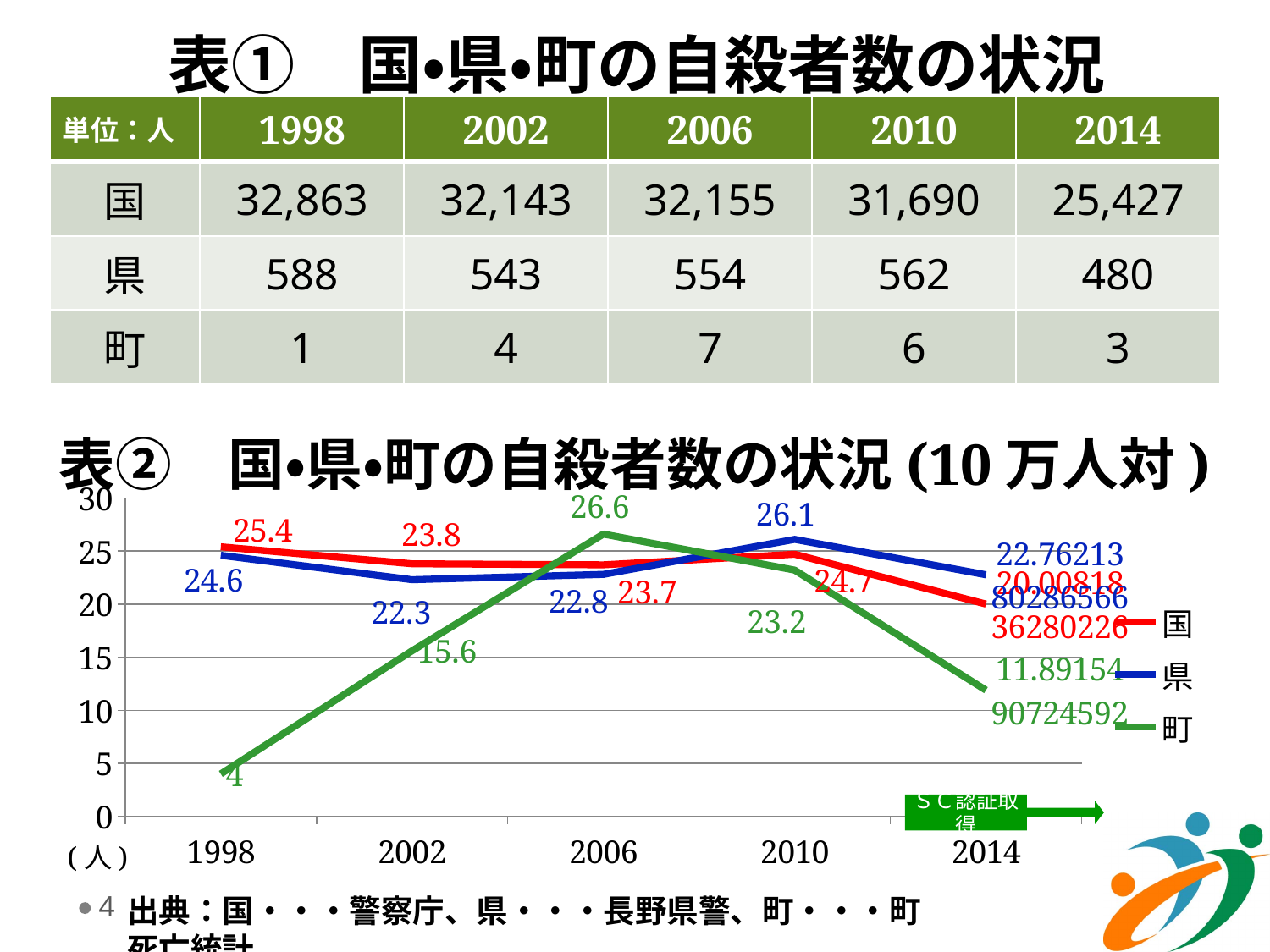
How many years are shown on the x axis of 表②? 5 In 表②, which is larger in 2002, the value for 国 or for 県? 国 In 表②, what is the difference between the 町 value in 2006 and in 1998? 22.6 How many series does the legend of 表② list? 3 In 表②, is the value for 町 in 2014 greater or less than 15? less In 表②, what is the value for 町 in 2006? 26.6 What kind of chart is 表② (the lower chart)? line chart In 表②, what is the value for 県 in 2010? 26.1 In 表②, what is the value for 国 in 1998? 25.4 In 表②, in which year is the 町 series at its lowest? 1998 In 表②, what is the value for 町 in 1998? 4 In 表②, in which year is the 町 series at its highest? 2006